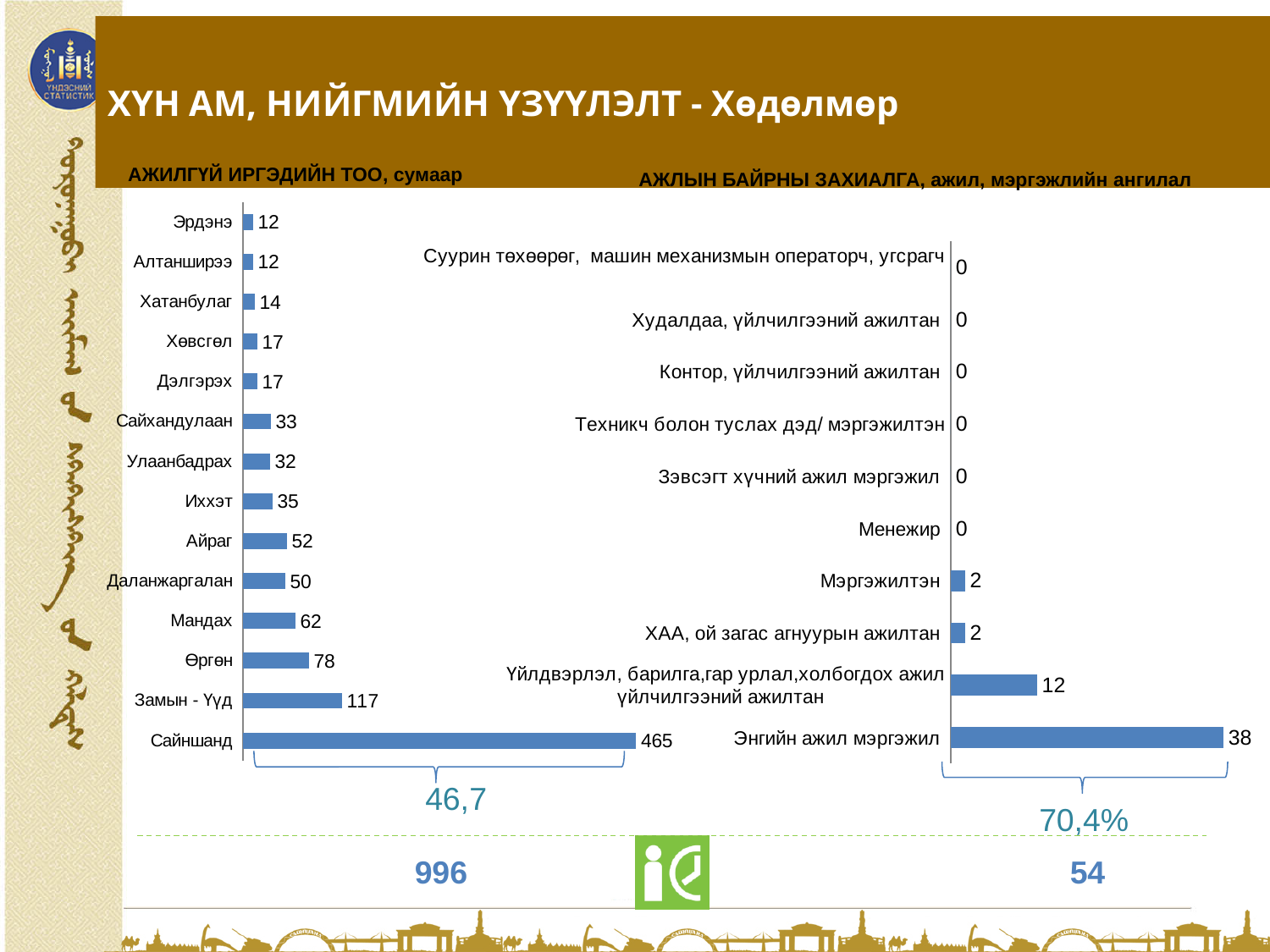
In the chart 'АЖИЛГҮЙ ИРГЭДИЙН ТОО, сумаар', what is the value for Замын - Үүд? 117 In the chart 'АЖЛЫН БАЙРНЫ ЗАХИАЛГА, ажил, мэргэжлийн ангилал', how many categories have a value of 0? 6 In the chart 'АЖЛЫН БАЙРНЫ ЗАХИАЛГА, ажил, мэргэжлийн ангилал', what is the value for Энгийн ажил мэргэжил? 38 In the chart 'АЖИЛГҮЙ ИРГЭДИЙН ТОО, сумаар', what is the value for Сайншанд? 465 How many categories are shown in the chart 'АЖИЛГҮЙ ИРГЭДИЙН ТОО, сумаар'? 14 In the chart 'АЖИЛГҮЙ ИРГЭДИЙН ТОО, сумаар', which category has the lowest value? Эрдэнэ and Алтанширээ (12) In the chart 'АЖИЛГҮЙ ИРГЭДИЙН ТОО, сумаар', what is the difference between Сайншанд and Замын - Үүд? 348 In the chart 'АЖЛЫН БАЙРНЫ ЗАХИАЛГА, ажил, мэргэжлийн ангилал', what is the value for Мэргэжилтэн? 2 In the chart 'АЖИЛГҮЙ ИРГЭДИЙН ТОО, сумаар', which category has the highest value? Сайншанд What type of chart is 'АЖЛЫН БАЙРНЫ ЗАХИАЛГА, ажил, мэргэжлийн ангилал'? Bar chart In the chart 'АЖИЛГҮЙ ИРГЭДИЙН ТОО, сумаар', which is larger, Өргөн or Мандах? Өргөн In the chart 'АЖЛЫН БАЙРНЫ ЗАХИАЛГА, ажил, мэргэжлийн ангилал', what is the difference between Энгийн ажил мэргэжил and Үйлдвэрлэл, барилга, гар урлал, холбогдох ажил үйлчилгээний ажилтан? 26